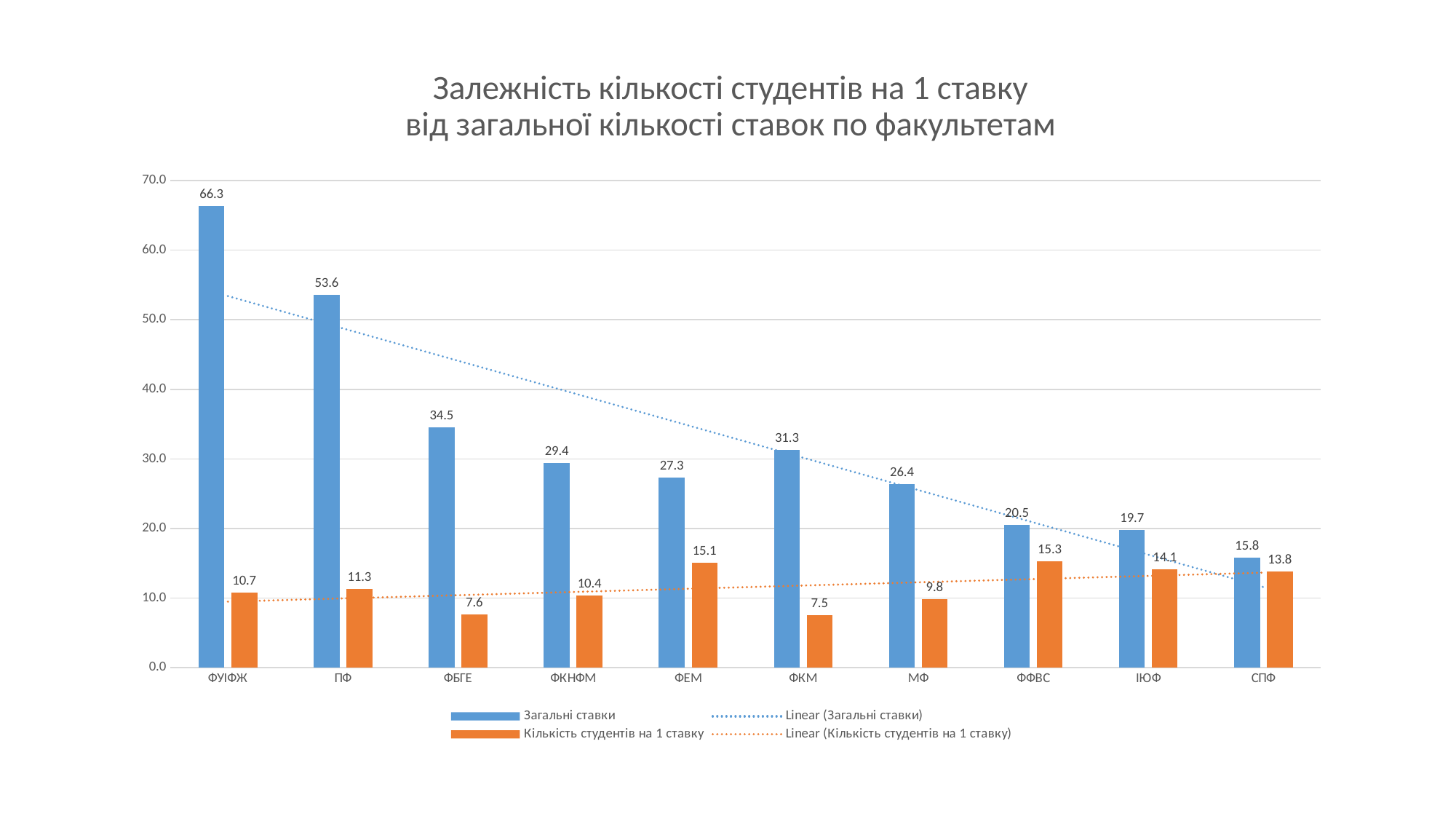
Which is larger, the Кількість студентів на 1 ставку value for ФФВС or for ІЮФ? ФФВС What kind of chart is shown on the slide? Bar chart Which faculty has the lowest value of Загальні ставки? СПФ How many entries does the legend list? 4 What is the value of Загальні ставки for ФУІФЖ? 66.3 How many faculties are shown on the x axis? 10 Which faculty has the lowest value of Кількість студентів на 1 ставку? ФКМ What is the value of Загальні ставки for ФКМ? 31.3 Which faculty has the highest value of Загальні ставки? ФУІФЖ What is the difference between the Загальні ставки values for ФУІФЖ and ПФ? 12.7 Is the Загальні ставки value for ФБГЕ greater or less than 30.0? greater What is the value of Кількість студентів на 1 ставку for ФЕМ? 15.1